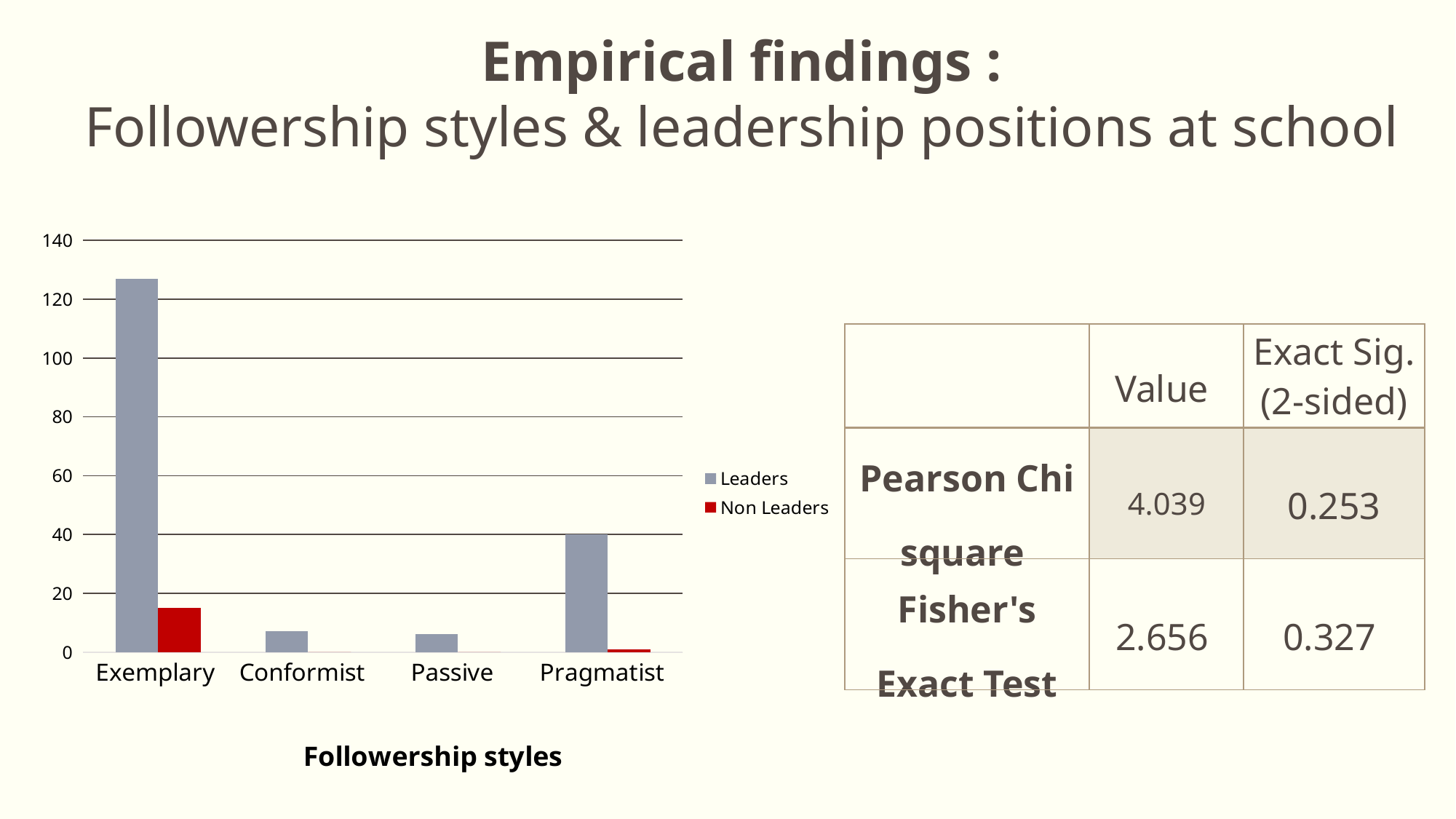
Is the Leaders value for Exemplary greater or less than 120? greater How many followership style categories are shown on the x axis of the chart? 4 Which followership style has the highest value for Leaders? Exemplary Is the Leaders value for Pragmatist greater or less than 20? greater Is the Leaders value for Conformist greater or less than 20? less Which is larger, the Leaders value for Pragmatist or the Leaders value for Conformist? Pragmatist Which followership style has the highest value for Non Leaders? Exemplary Which is larger, the Leaders value for Exemplary or the Leaders value for Pragmatist? Exemplary What kind of chart is shown on the slide? bar chart How many series does the chart legend list? 2 What is the title of the x axis of the chart? Followership styles